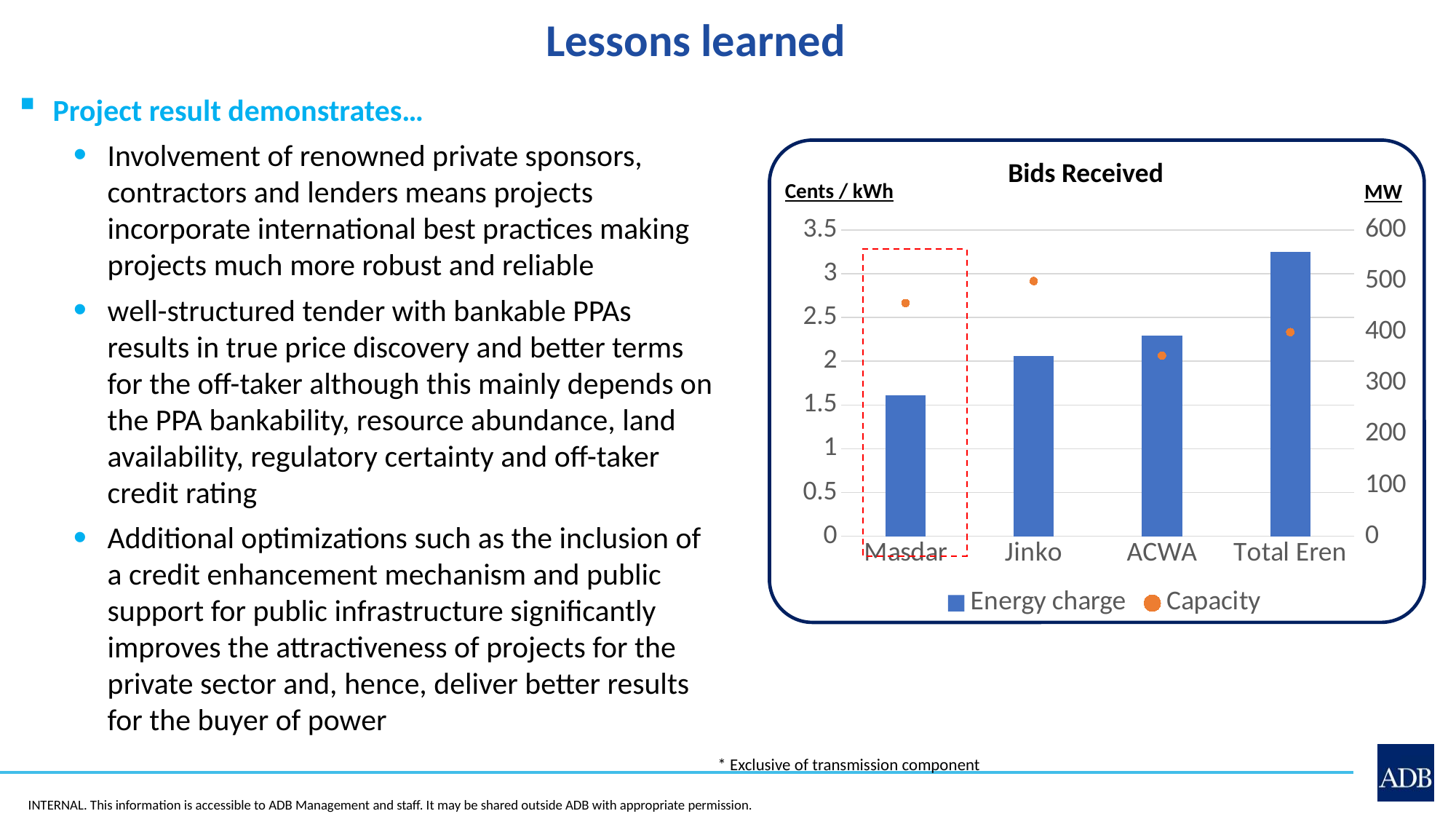
What type of chart is shown in the 'Bids Received' chart? bar chart Which bidder has the lowest Energy charge in the 'Bids Received' chart? Masdar In the 'Bids Received' chart, which has the larger Energy charge, Jinko or ACWA? ACWA Which bidder has the lowest Capacity in the 'Bids Received' chart? ACWA What unit is shown on the right-hand axis of the 'Bids Received' chart? MW Do the Energy charge bars rise or fall from Masdar to Total Eren in the 'Bids Received' chart? rise How many series does the legend of the 'Bids Received' chart list? 2 Which bidder has the highest Capacity in the 'Bids Received' chart? Jinko How many bidders are shown on the x axis of the 'Bids Received' chart? 4 Which bidder has the highest Energy charge in the 'Bids Received' chart? Total Eren In the 'Bids Received' chart, is the Energy charge for Masdar greater or less than 2? less In the 'Bids Received' chart, is the Energy charge for Total Eren greater or less than 3? greater